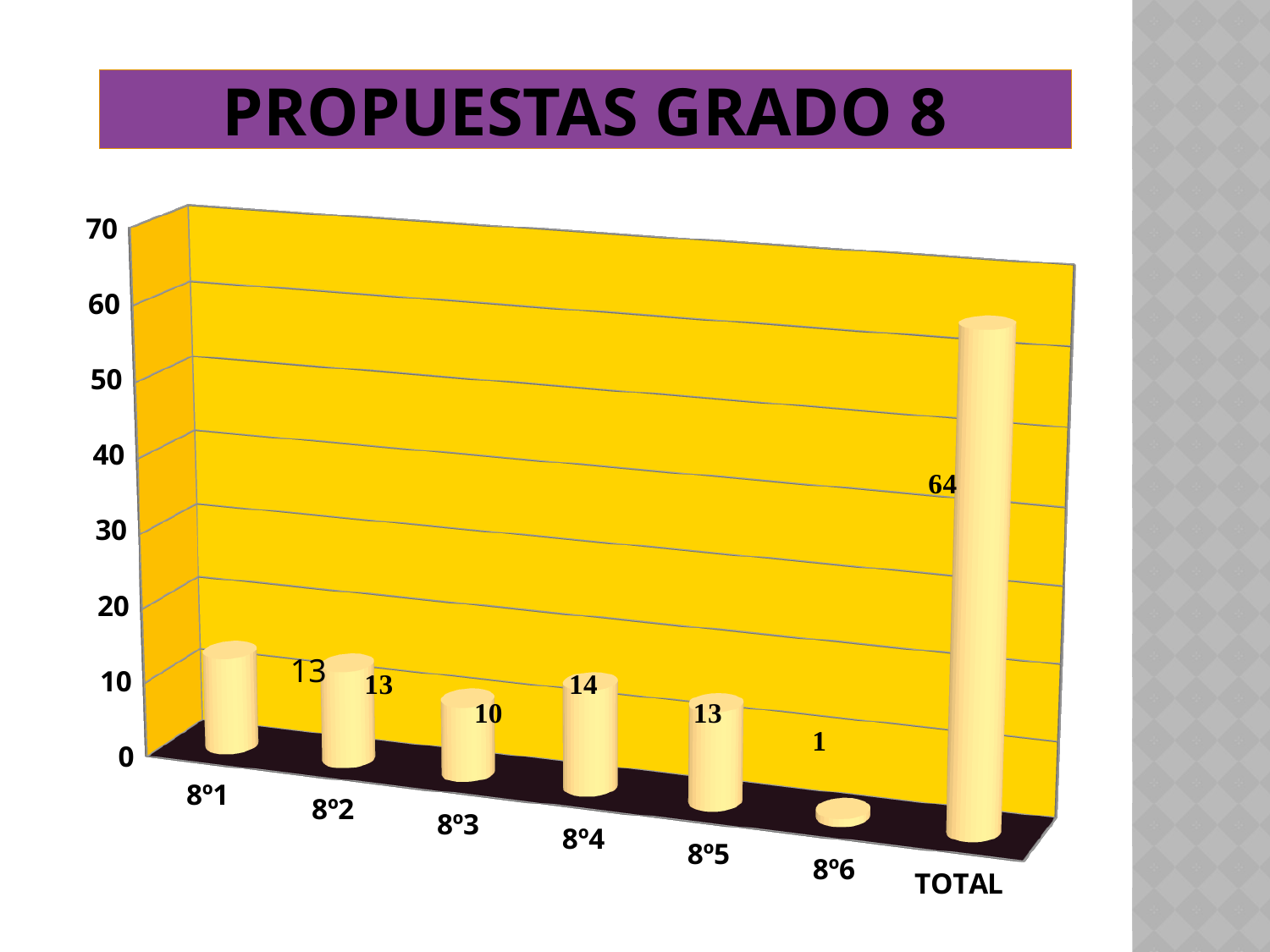
What is the value for 8º6? 1 How many categories are shown on the x axis? 7 What is the difference between the values for TOTAL and 8º4? 50 Which is larger, the value for 8º2 or the value for 8º6? 8º2 Is the value for TOTAL greater or less than 50? greater What kind of chart is shown on the slide? bar chart Which category has the lowest value? 8º6 What is the value for 8º3? 10 What is the difference between the values for 8º4 and 8º3? 4 What is the value for 8º4? 14 What is the value for TOTAL? 64 Excluding TOTAL, which class group has the highest value? 8º4